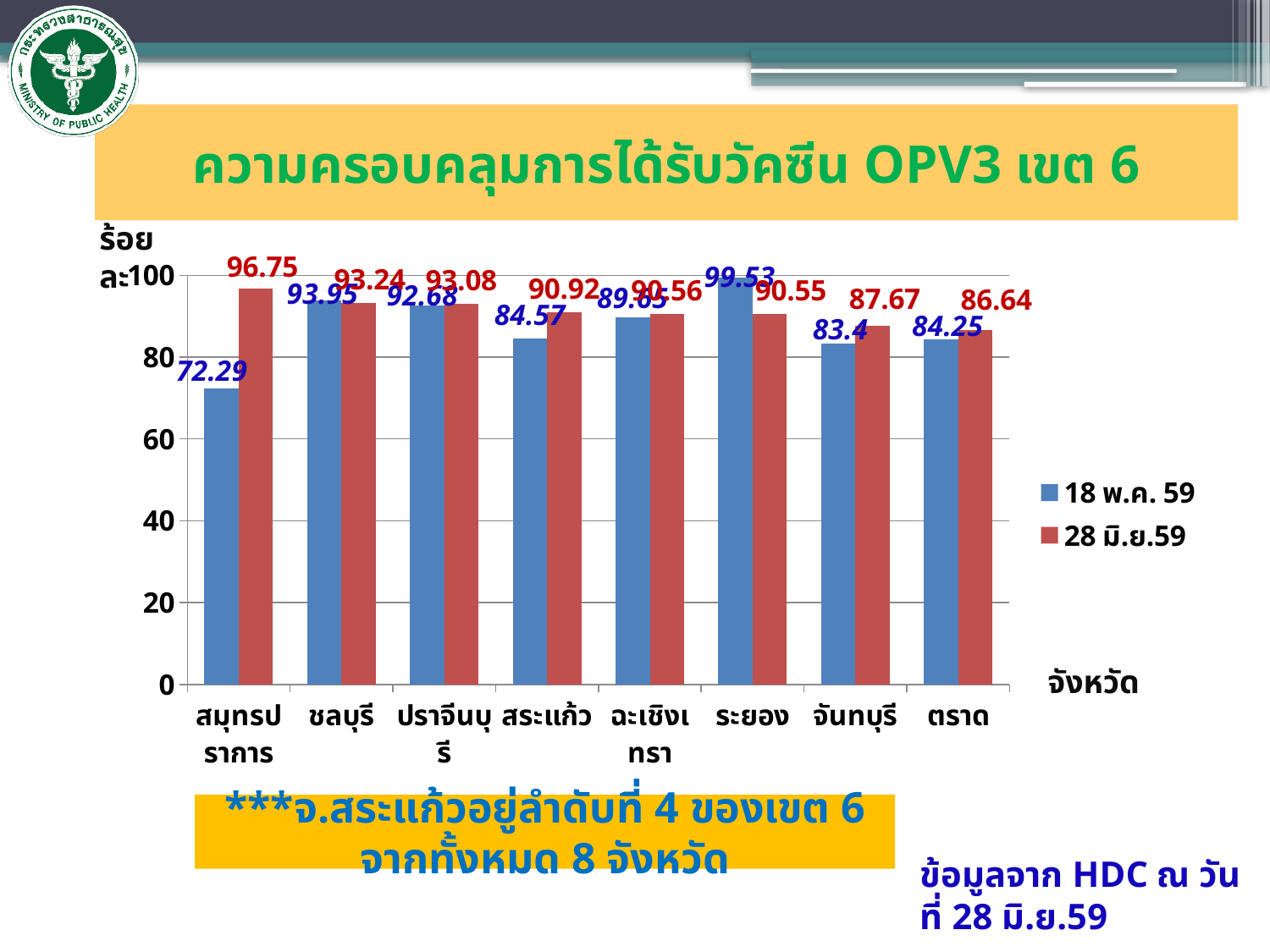
What kind of chart is shown on the slide? bar chart Is the 18 พ.ค. 59 value for สมุทรปราการ greater or less than 80? less What is the value for ตราด in the 28 มิ.ย.59 series? 86.64 Which province has the lowest value in the 18 พ.ค. 59 series? สมุทรปราการ What is the value for สมุทรปราการ in the 28 มิ.ย.59 series? 96.75 For ระยอง, which series has the larger value, 18 พ.ค. 59 or 28 มิ.ย.59? 18 พ.ค. 59 How many provinces are shown on the x axis? 8 How many series does the legend list? 2 What is the difference between the 28 มิ.ย.59 and 18 พ.ค. 59 values for สมุทรปราการ? 24.46 What is the value for สระแก้ว in the 18 พ.ค. 59 series? 84.57 Which province has the lowest value in the 28 มิ.ย.59 series? ตราด Which province has the highest value in the 18 พ.ค. 59 series? ระยอง